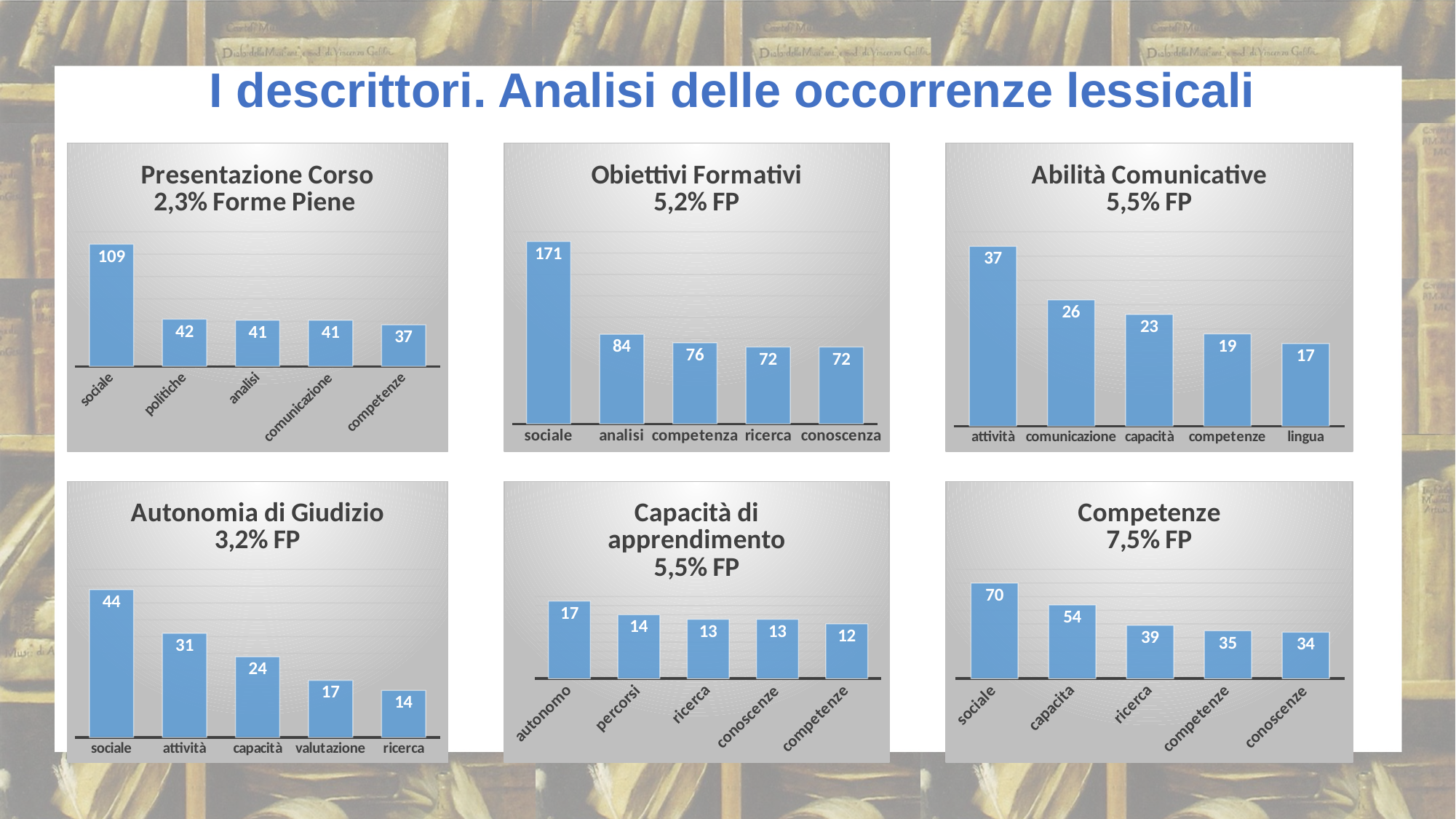
In the 'Competenze 7,5% FP' chart, do the values rise or fall from left to right? fall In the 'Abilità Comunicative 5,5% FP' chart, which category has the lowest value? lingua How many charts are shown on the slide? 6 What kind of chart is the 'Competenze 7,5% FP' chart? bar chart How many categories are shown in the 'Capacità di apprendimento 5,5% FP' chart? 5 In the 'Autonomia di Giudizio 3,2% FP' chart, which is larger, the value for attività or the value for capacità? attività In the 'Obiettivi Formativi 5,2% FP' chart, what is the difference between the values for sociale and analisi? 87 In the 'Autonomia di Giudizio 3,2% FP' chart, what is the value for ricerca? 14 In the 'Obiettivi Formativi 5,2% FP' chart, which category has the highest value? sociale In the 'Abilità Comunicative 5,5% FP' chart, what is the difference between the values for attività and comunicazione? 11 In the 'Presentazione Corso 2,3% Forme Piene' chart, what is the value for sociale? 109 In the 'Capacità di apprendimento 5,5% FP' chart, what is the value for percorsi? 14